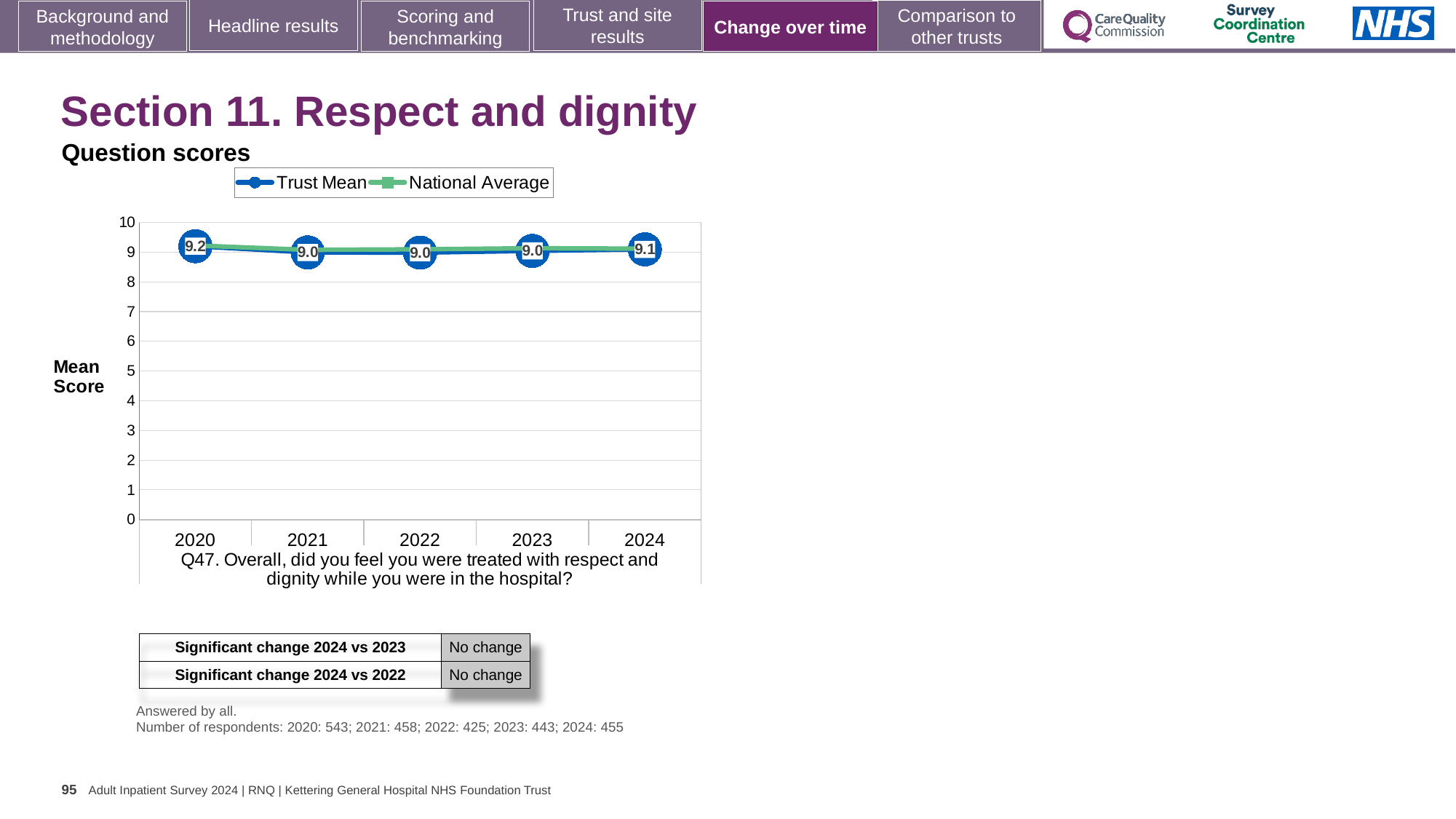
What is the label of the y axis? Mean Score What is the Trust Mean score for 2024? 9.1 Is the National Average value for 2022 greater or less than 8? greater What is the difference between the Trust Mean scores for 2020 and 2024? 0.1 What is the Trust Mean score for 2022? 9.0 How many series does the legend list? 2 In which year is the Trust Mean score highest? 2020 How many years are plotted on the x axis? 5 What kind of chart is shown? line chart What is the Trust Mean score for 2020? 9.2 Which year has the larger Trust Mean score, 2020 or 2021? 2020 Did the Trust Mean score rise or fall from 2020 to 2021? fall